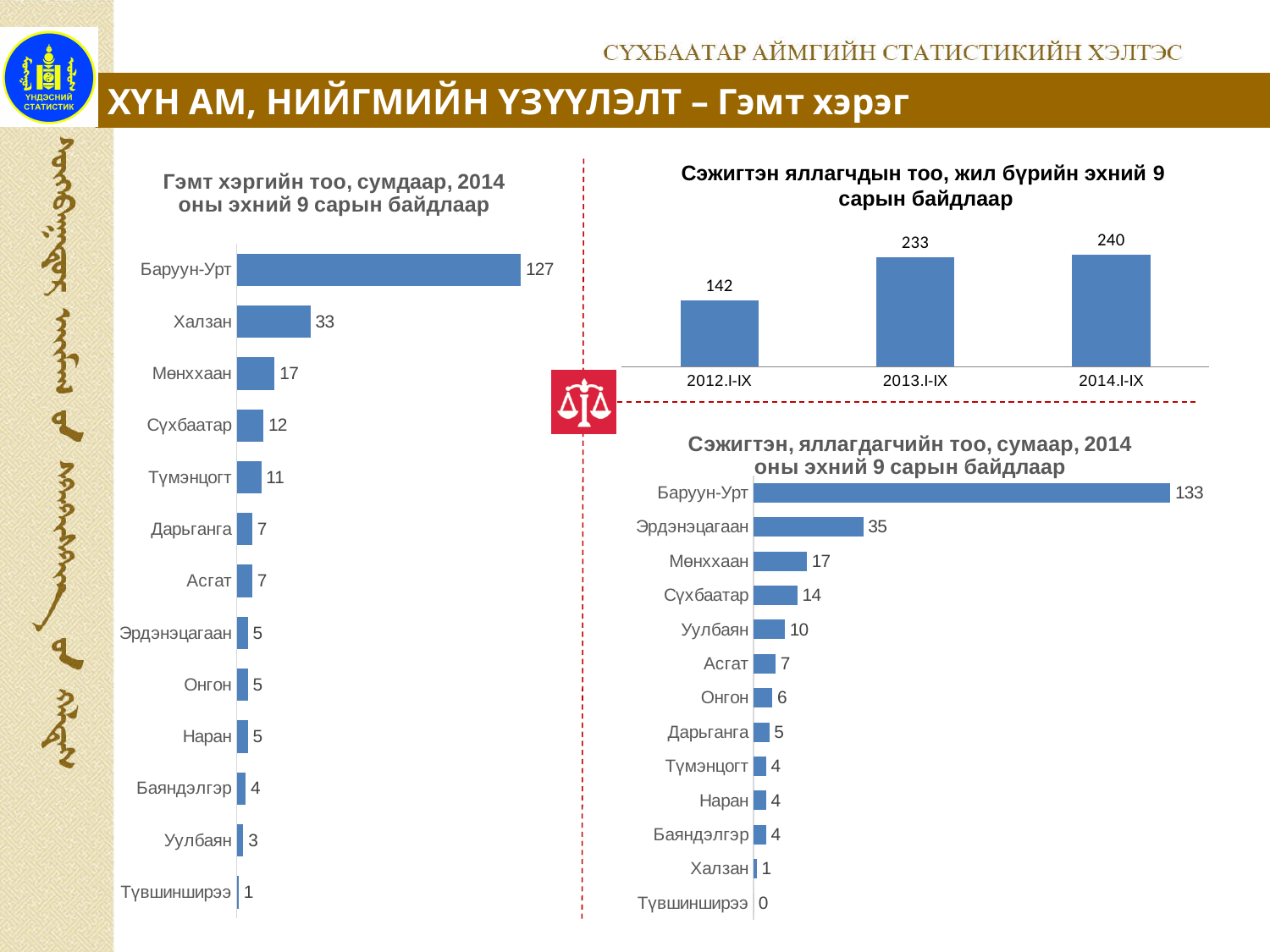
In the left chart 'Гэмт хэргийн тоо, сумдаар, 2014 оны эхний 9 сарын байдлаар', which sum has the lowest value? Түвшинширээ In the left chart 'Гэмт хэргийн тоо, сумдаар, 2014 оны эхний 9 сарын байдлаар', how many sums are listed? 13 In the top right chart 'Сэжигтэн яллагчдын тоо, жил бүрийн эхний 9 сарын байдлаар', what is the value for 2013.I-IX? 233 In the bottom right chart 'Сэжигтэн, яллагдагчийн тоо, сумаар, 2014 оны эхний 9 сарын байдлаар', which sum has the highest value? Баруун-Урт In the top right chart 'Сэжигтэн яллагчдын тоо, жил бүрийн эхний 9 сарын байдлаар', do the values rise or fall from 2012.I-IX to 2014.I-IX? rise In the bottom right chart 'Сэжигтэн, яллагдагчийн тоо, сумаар, 2014 оны эхний 9 сарын байдлаар', what is the value for Түвшинширээ? 0 In the bottom right chart 'Сэжигтэн, яллагдагчийн тоо, сумаар, 2014 оны эхний 9 сарын байдлаар', what is the value for Эрдэнэцагаан? 35 What kind of chart is the top right chart 'Сэжигтэн яллагчдын тоо, жил бүрийн эхний 9 сарын байдлаар'? bar chart In the top right chart 'Сэжигтэн яллагчдын тоо, жил бүрийн эхний 9 сарын байдлаар', what is the difference between 2014.I-IX and 2012.I-IX? 98 In the left chart 'Гэмт хэргийн тоо, сумдаар, 2014 оны эхний 9 сарын байдлаар', what is the value for Баруун-Урт? 127 In the bottom right chart 'Сэжигтэн, яллагдагчийн тоо, сумаар, 2014 оны эхний 9 сарын байдлаар', which is larger, Уулбаян or Асгат? Уулбаян In the left chart 'Гэмт хэргийн тоо, сумдаар, 2014 оны эхний 9 сарын байдлаар', what is the difference between Халзан and Мөнххаан? 16